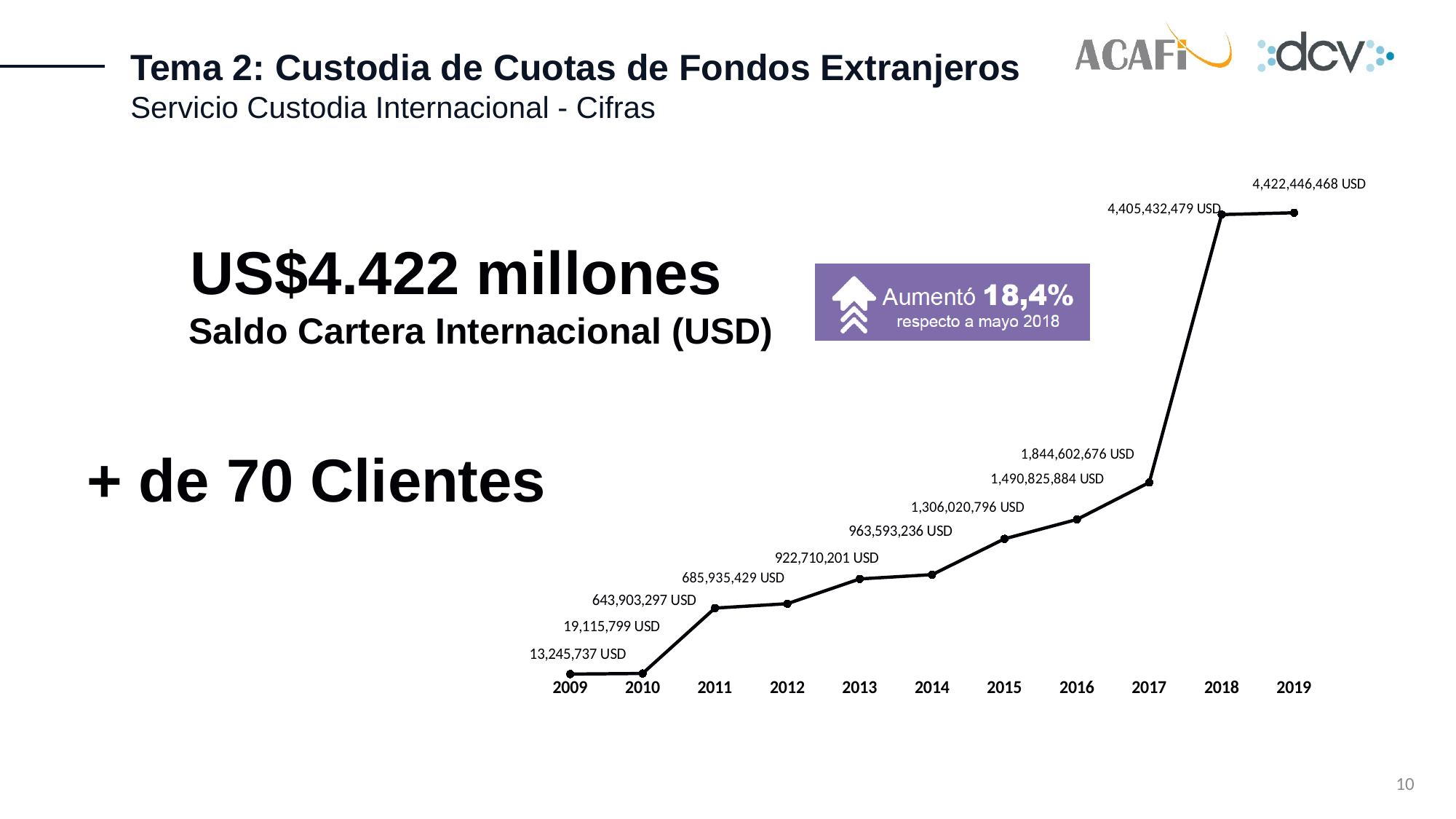
Which year has the highest value on the line chart? 2019 What is the value for 2011 on the line chart? 643,903,297 USD What is the value for 2009 on the line chart? 13,245,737 USD What is the value for 2015 on the line chart? 1,306,020,796 USD What is the difference between the values for 2017 and 2016? 353,776,792 USD Which year has the lowest value on the line chart? 2009 What is the difference between the values for 2019 and 2018? 17,013,989 USD Do the values rise or fall from 2009 to 2019? Rise Which year has the larger value, 2013 or 2014? 2014 What kind of chart is shown on the slide? Line chart What is the value for 2019 on the line chart? 4,422,446,468 USD How many years are plotted on the line chart? 11